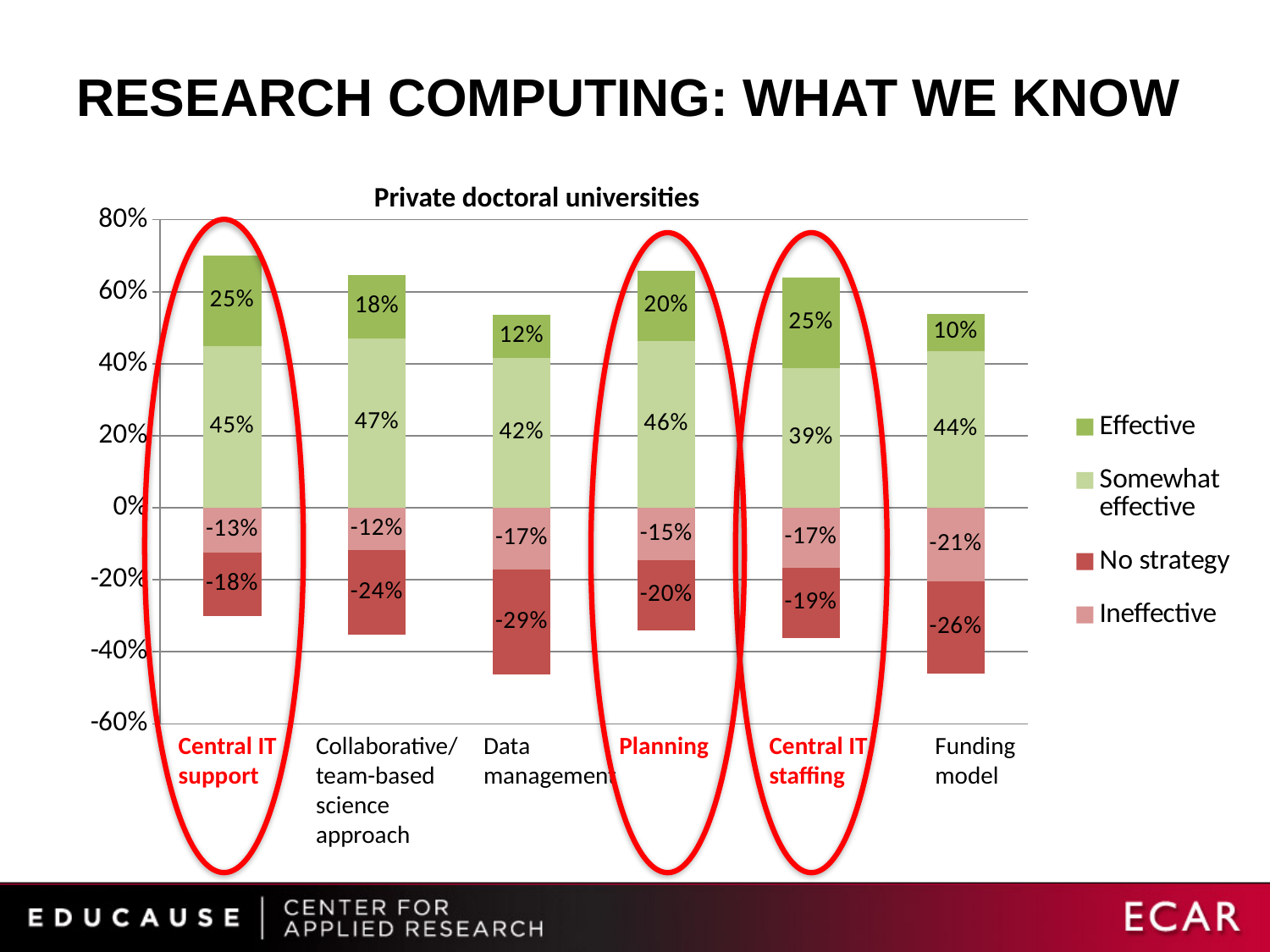
What is the Somewhat effective value for Data management? 42% What is the difference between the Effective values for Central IT support and Data management? 13 percentage points What is the Ineffective value for Planning? -15% Which has a larger Somewhat effective value, Planning or Central IT staffing? Planning Which category has the highest Somewhat effective value? Collaborative/team-based science approach How many series does the legend list? 4 How many categories are shown on the x axis? 6 Which category has the lowest Effective value? Funding model What kind of chart is shown? Stacked bar chart What is the No strategy value for Funding model? -26% What is the combined total of the Effective and Somewhat effective segments for Central IT support? 70% What is the Effective value for Central IT support? 25%